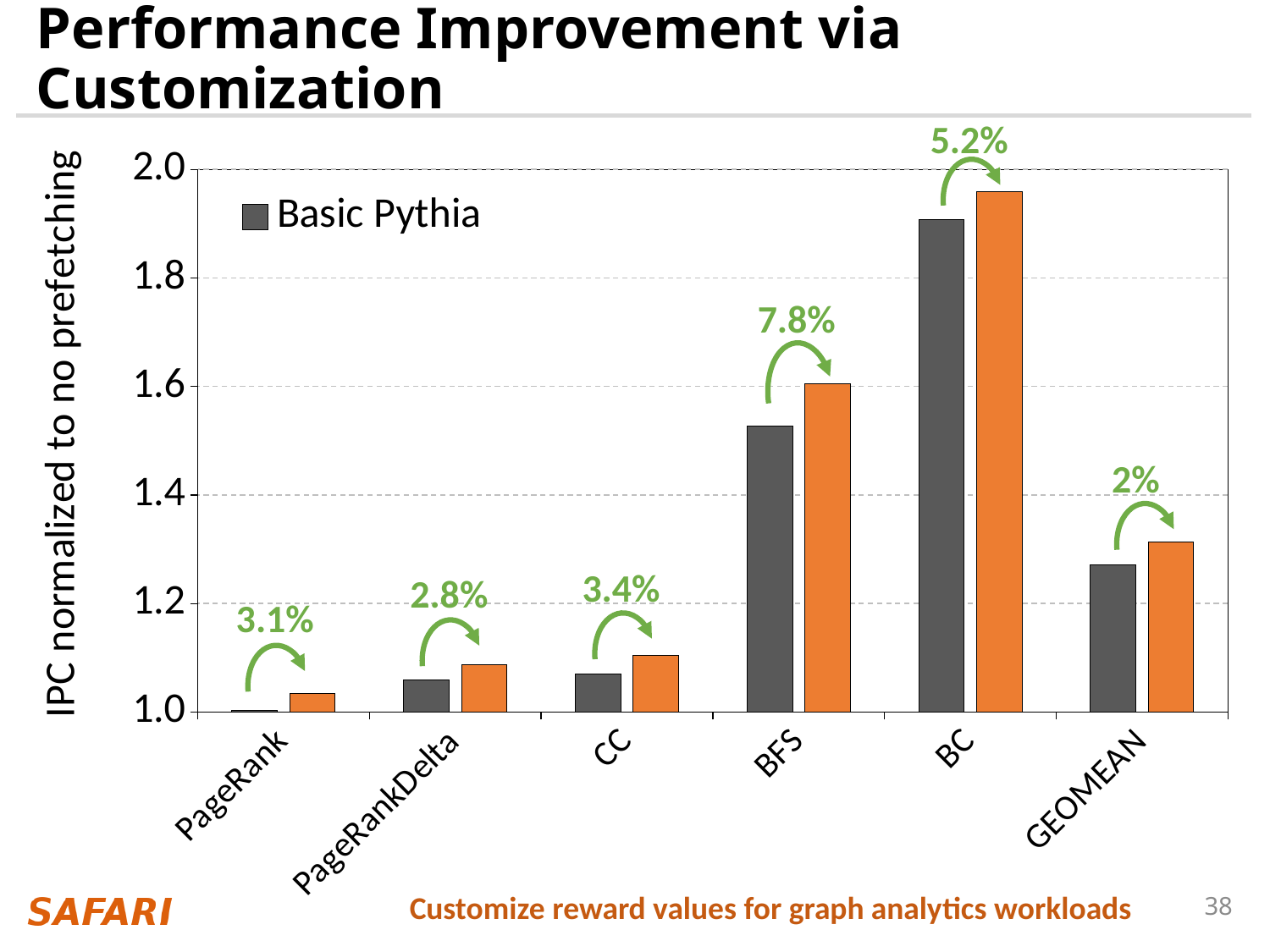
Which workload has the highest Basic Pythia IPC? BC What improvement percentage is annotated above the PageRankDelta bars? 2.8% How many workload categories are shown on the x axis? 6 How many series does the legend list? 1 Which workload has the lowest Basic Pythia IPC? PageRank What kind of chart is shown on the slide? bar chart Is the Basic Pythia value for BC greater or less than 1.8? greater What improvement percentage is annotated above the BFS bars? 7.8% What is the name of the series listed in the legend? Basic Pythia What is the y-axis label of the chart? IPC normalized to no prefetching Is the Basic Pythia value for GEOMEAN greater or less than 1.4? less What improvement percentage is annotated above the GEOMEAN bars? 2%